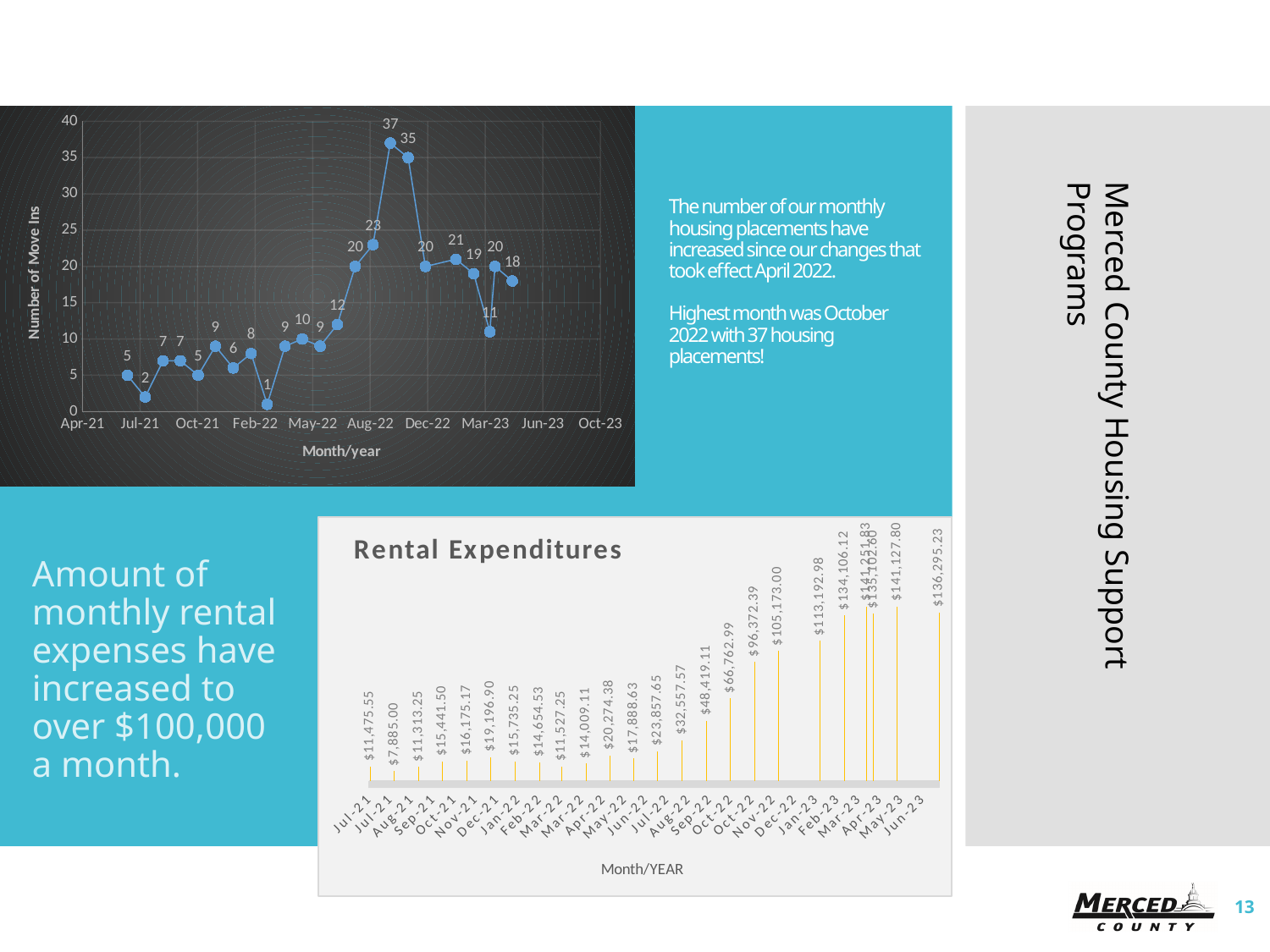
In the Rental Expenditures chart, do the values generally rise or fall from left to right along the x axis? rise In the Rental Expenditures chart, what is the lowest value shown? $7,885.00 What kind of chart is the top-left chart showing Number of Move Ins? line chart In the Rental Expenditures chart, what is the value of the last bar (Jun-23)? $136,295.23 In the top-left chart, what is the highest number of move ins shown? 37 What kind of chart is the Rental Expenditures chart? bar chart What is the title of the bottom chart? Rental Expenditures In the top-left chart, what is the lowest number of move ins shown? 1 In the top-left chart, what is the difference between the highest and lowest number of move ins? 36 In the Rental Expenditures chart, what is the highest value shown? $141,251.83 What is the y-axis title of the top-left chart? Number of Move Ins In the Rental Expenditures chart, what is the value of the first bar (Jul-21)? $11,475.55